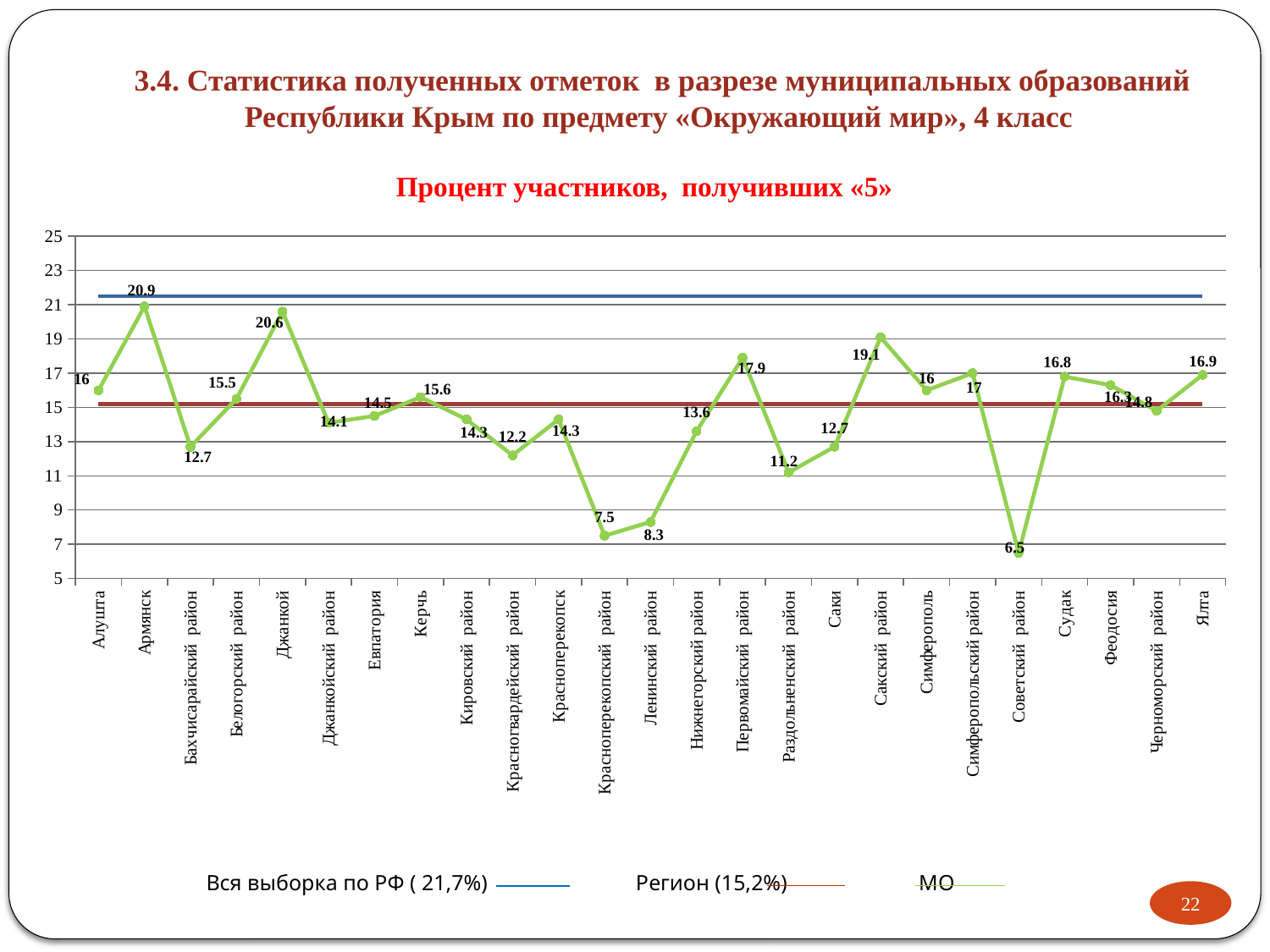
What type of chart is shown on the slide? line chart Is the value for Красноперекопский район greater or less than 9? less What value does the legend give for the series «Вся выборка по РФ»? 21,7% What is the value for Армянск? 20.9 Which municipality has the lowest percentage of participants receiving «5»? Советский район What is the difference between the values for Джанкой and Джанкойский район? 6.5 What is the value for Советский район? 6.5 Which has a larger value, Сакский район or Саки? Сакский район How many municipalities are plotted on the x axis? 25 How many series does the legend list? 3 What is the value for Первомайский район? 17.9 Which municipality has the highest percentage of participants receiving «5»? Армянск